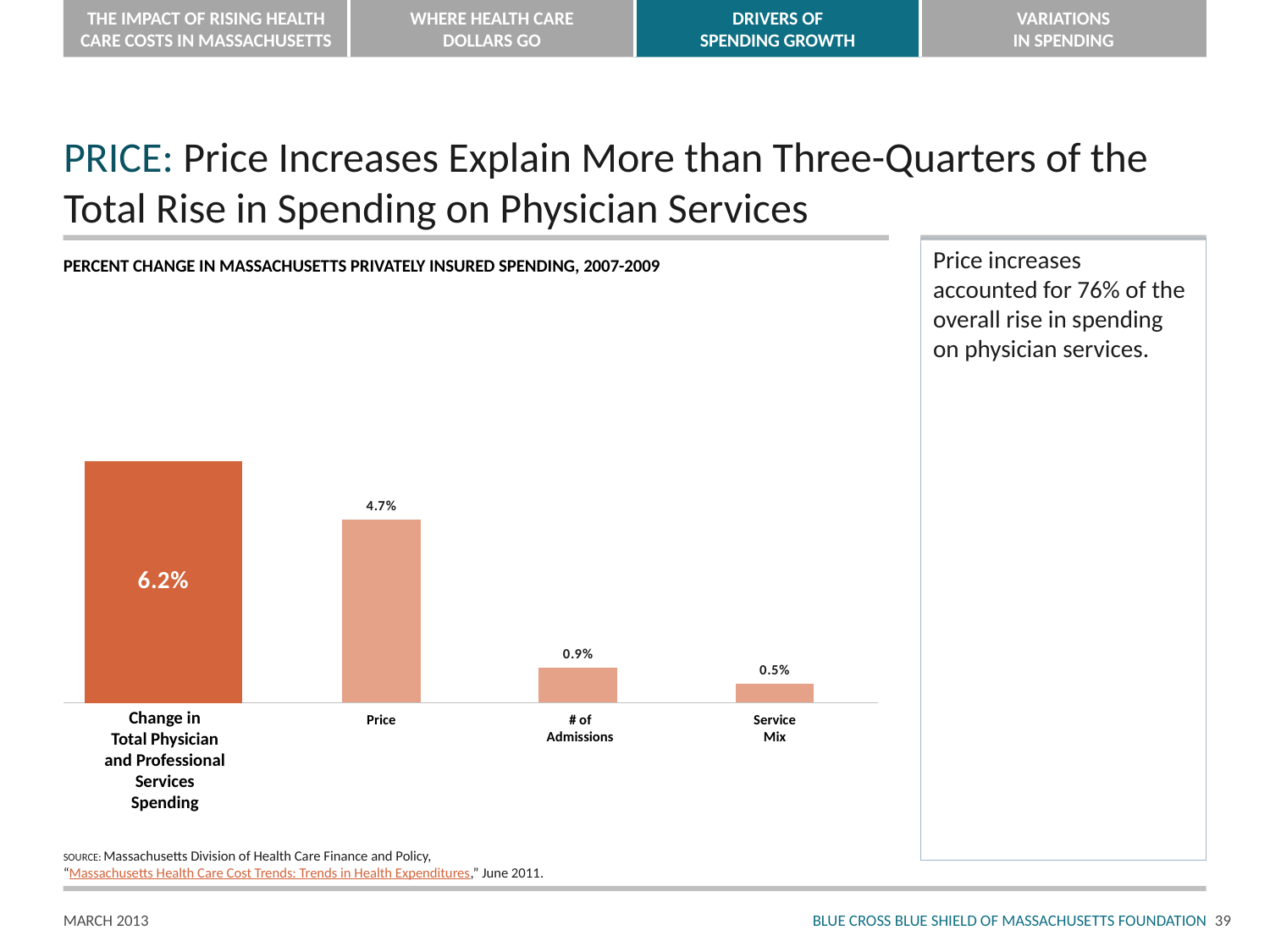
What is the difference between the values for # of Admissions and Service Mix? 0.4% Which category has the highest value? Change in Total Physician and Professional Services Spending Which category has the lowest value? Service Mix What kind of chart is shown on the slide? Bar chart What is the value for Change in Total Physician and Professional Services Spending? 6.2% Which is larger, the value for Price or the value for Service Mix? Price What is the title of the chart? Percent Change in Massachusetts Privately Insured Spending, 2007-2009 What is the difference between the values for Price and # of Admissions? 3.8% What is the value for Service Mix? 0.5% What is the value for # of Admissions? 0.9% What is the value for Price? 4.7% How many categories are shown in the chart? 4